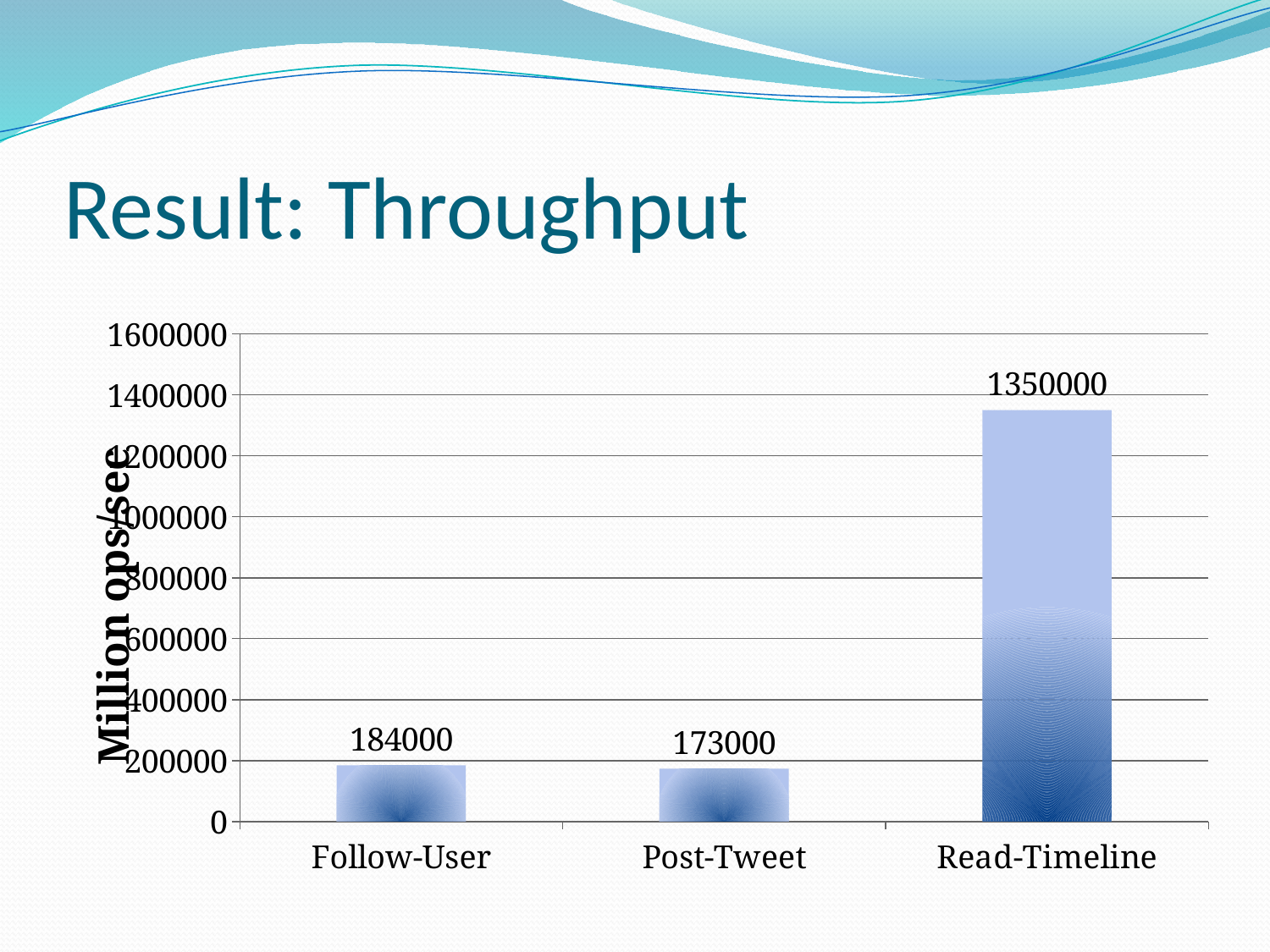
Is the value for Read-Timeline greater or less than 1200000? greater What kind of chart is shown on the slide? bar chart Which category has the lowest value? Post-Tweet What is the difference between the values for Follow-User and Post-Tweet? 11000 How many categories are shown on the x axis? 3 Which category has the highest value? Read-Timeline What is the difference between the values for Read-Timeline and Follow-User? 1166000 What is the label on the vertical axis of the chart? Million ops/sec What is the value for Read-Timeline? 1350000 Which is larger, the value for Follow-User or the value for Read-Timeline? Read-Timeline What is the value for Follow-User? 184000 What is the value for Post-Tweet? 173000